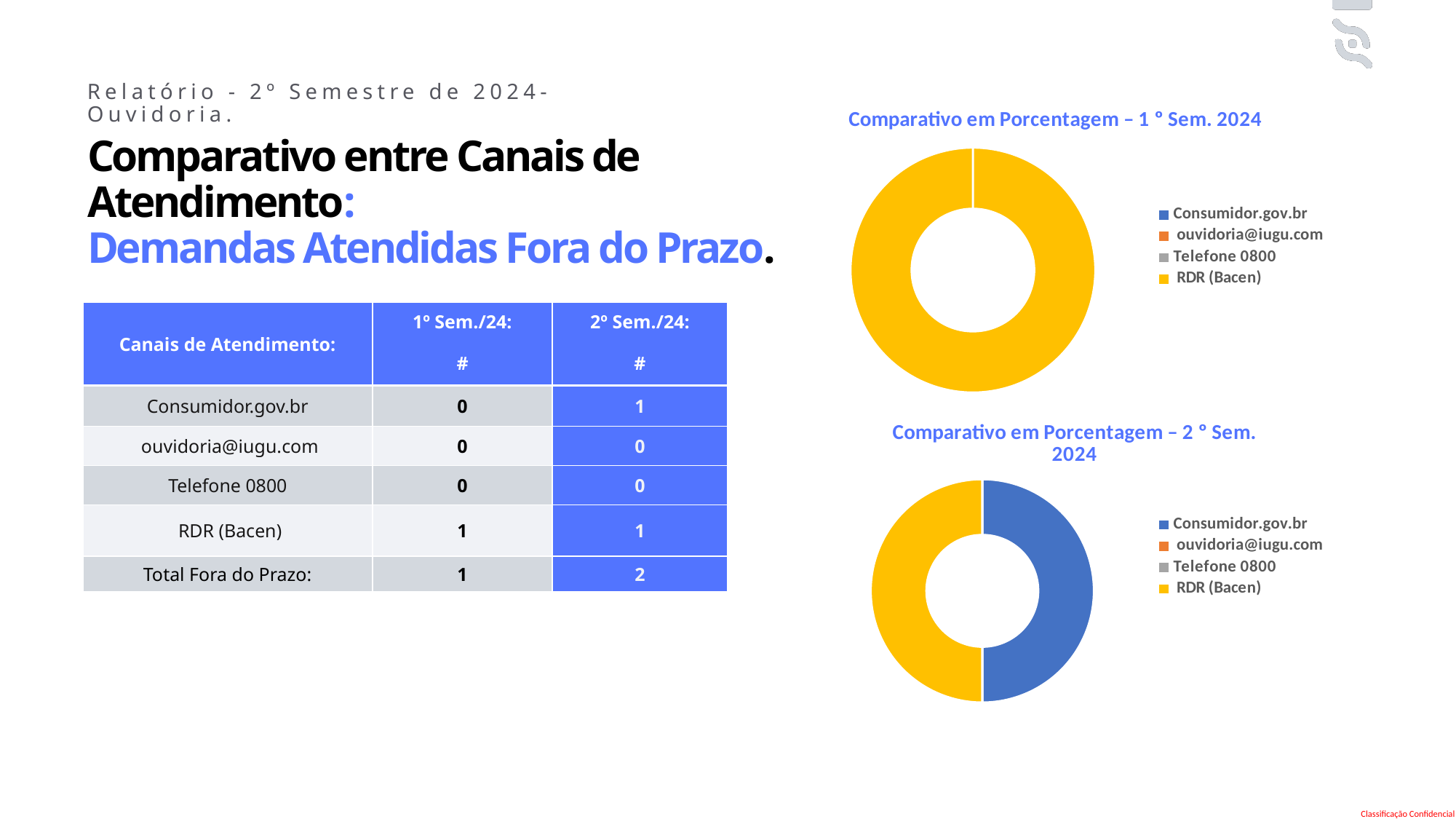
What kind of chart is "Comparativo em Porcentagem – 2 ° Sem. 2024"? Doughnut chart What colour represents RDR (Bacen) in the legend of the "Comparativo em Porcentagem – 2 ° Sem. 2024" chart? Yellow In the "Comparativo em Porcentagem – 1 ° Sem. 2024" chart, is the slice for Consumidor.gov.br larger or smaller than the slice for RDR (Bacen)? Smaller In the "Comparativo em Porcentagem – 1 ° Sem. 2024" chart, what share of the doughnut does RDR (Bacen) take? 100% In the "Comparativo em Porcentagem – 2 ° Sem. 2024" chart, what share of the doughnut does Consumidor.gov.br take? 50% How many entries does the legend of the "Comparativo em Porcentagem – 2 ° Sem. 2024" chart list? 4 How many entries does the legend of the "Comparativo em Porcentagem – 1 ° Sem. 2024" chart list? 4 In the "Comparativo em Porcentagem – 2 ° Sem. 2024" chart, what share of the doughnut does RDR (Bacen) take? 50% In the "Comparativo em Porcentagem – 2 ° Sem. 2024" chart, which two channels have visible slices? Consumidor.gov.br and RDR (Bacen) What kind of chart is "Comparativo em Porcentagem – 1 ° Sem. 2024"? Doughnut chart In the "Comparativo em Porcentagem – 1 ° Sem. 2024" chart, which channel has the largest slice? RDR (Bacen)